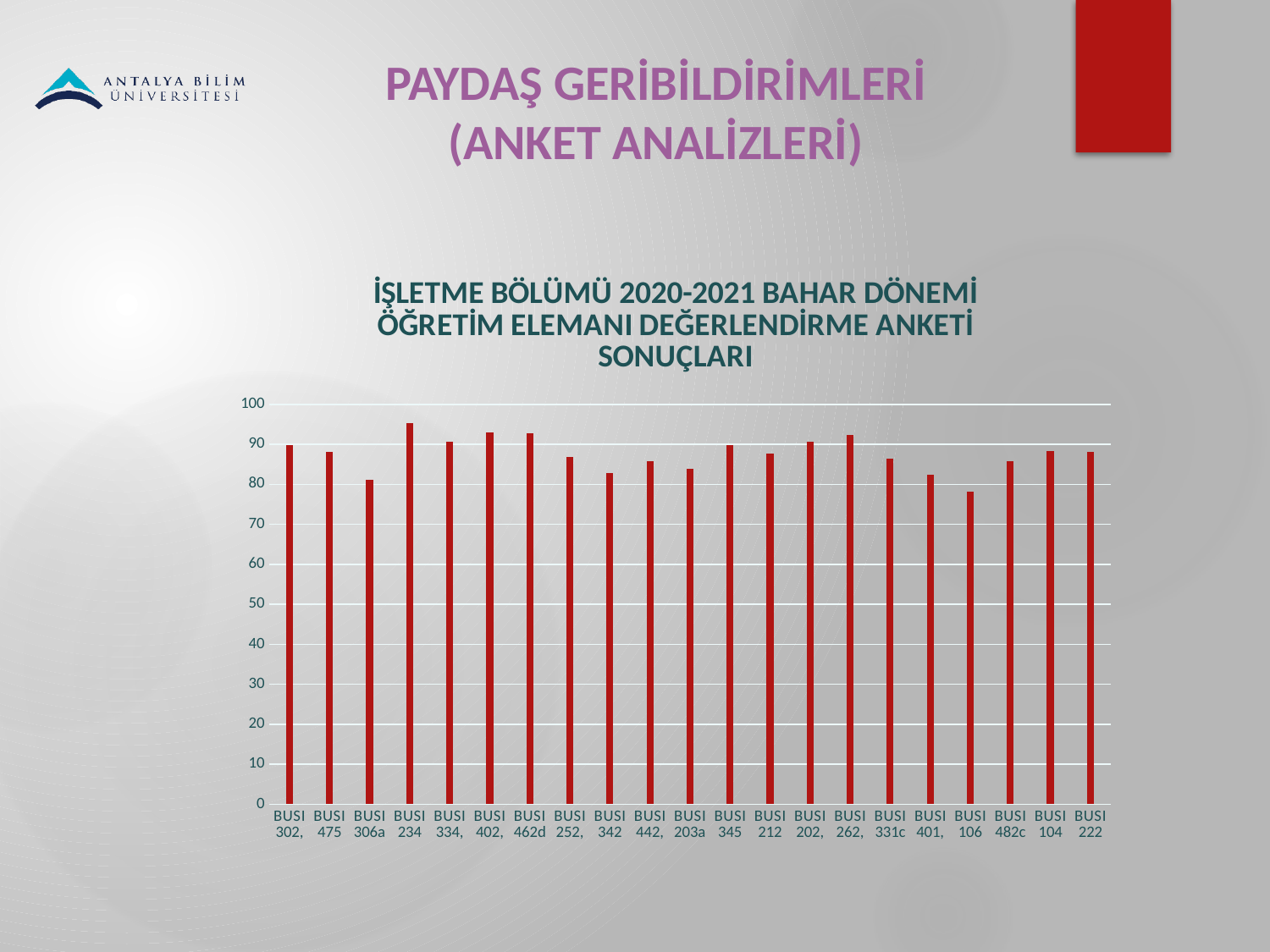
Is the value for BUSI 106 greater or less than 80? less Is the value for BUSI 302 greater or less than 80? greater Which has the larger value, BUSI 402 or BUSI 342? BUSI 402 What is the title of the chart? İŞLETME BÖLÜMÜ 2020-2021 BAHAR DÖNEMİ ÖĞRETİM ELEMANI DEĞERLENDİRME ANKETİ SONUÇLARI Is the value for BUSI 442 greater or less than 90? less Which course has the lowest bar in the chart? BUSI 106 How many course categories are shown on the x axis of the chart? 21 What colour are the bars in the chart? red What kind of chart is shown on the slide? bar chart Which has the larger value, BUSI 306a or BUSI 202? BUSI 202 Which course has the highest bar in the chart? BUSI 234